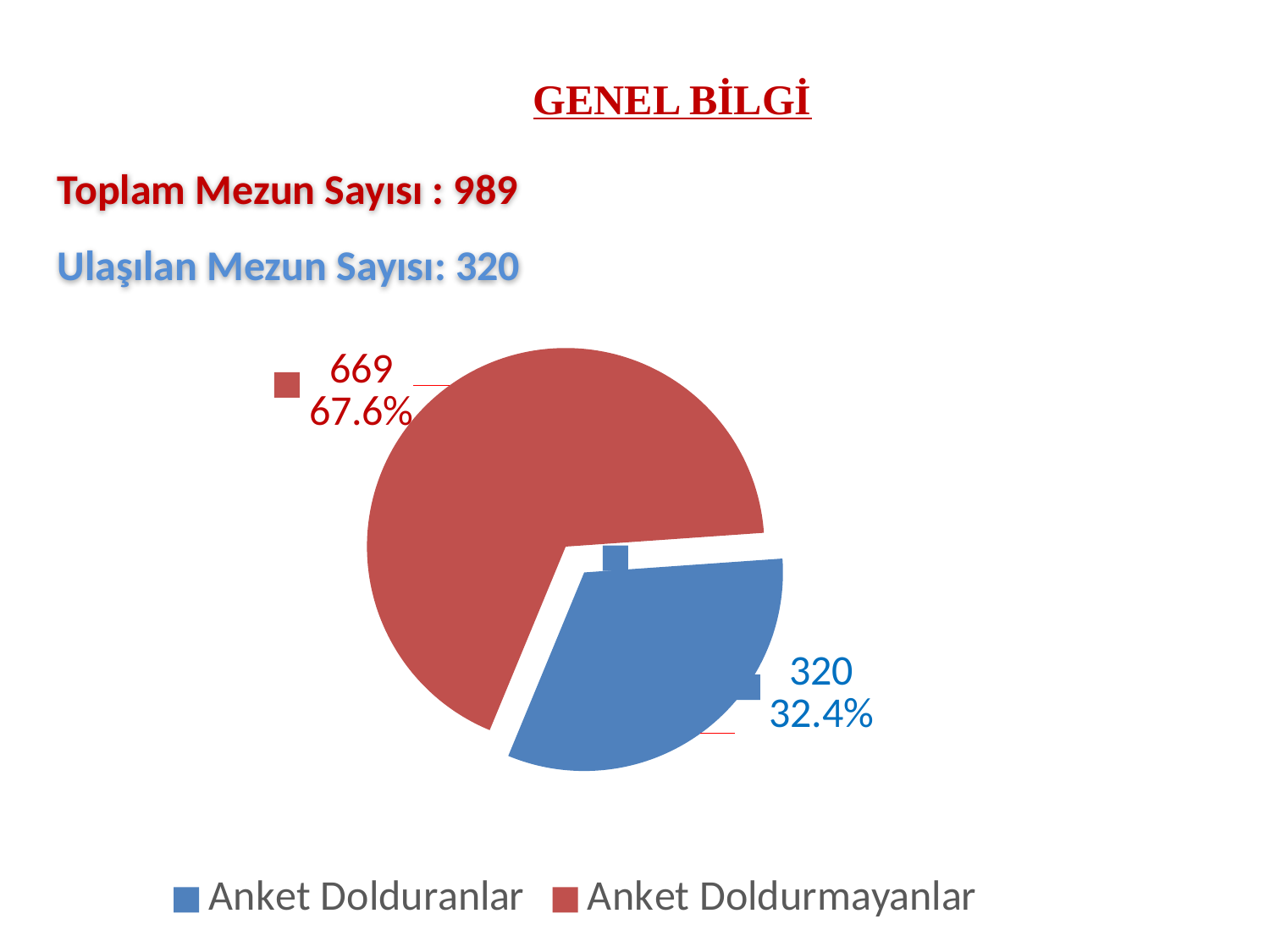
What percentage share of the pie is Anket Doldurmayanlar? 67.6% What kind of chart is shown on the slide? pie chart What is the value for Anket Dolduranlar? 320 What is the value for Anket Doldurmayanlar? 669 What colour is the Anket Dolduranlar slice? blue What percentage share of the pie is Anket Dolduranlar? 32.4% How many entries does the legend list? 2 Which is larger, Anket Dolduranlar or Anket Doldurmayanlar? Anket Doldurmayanlar What is the difference between the values for Anket Doldurmayanlar and Anket Dolduranlar? 349 Which slice is the largest? Anket Doldurmayanlar How many slices does the pie chart have? 2 Which slice is the smallest? Anket Dolduranlar